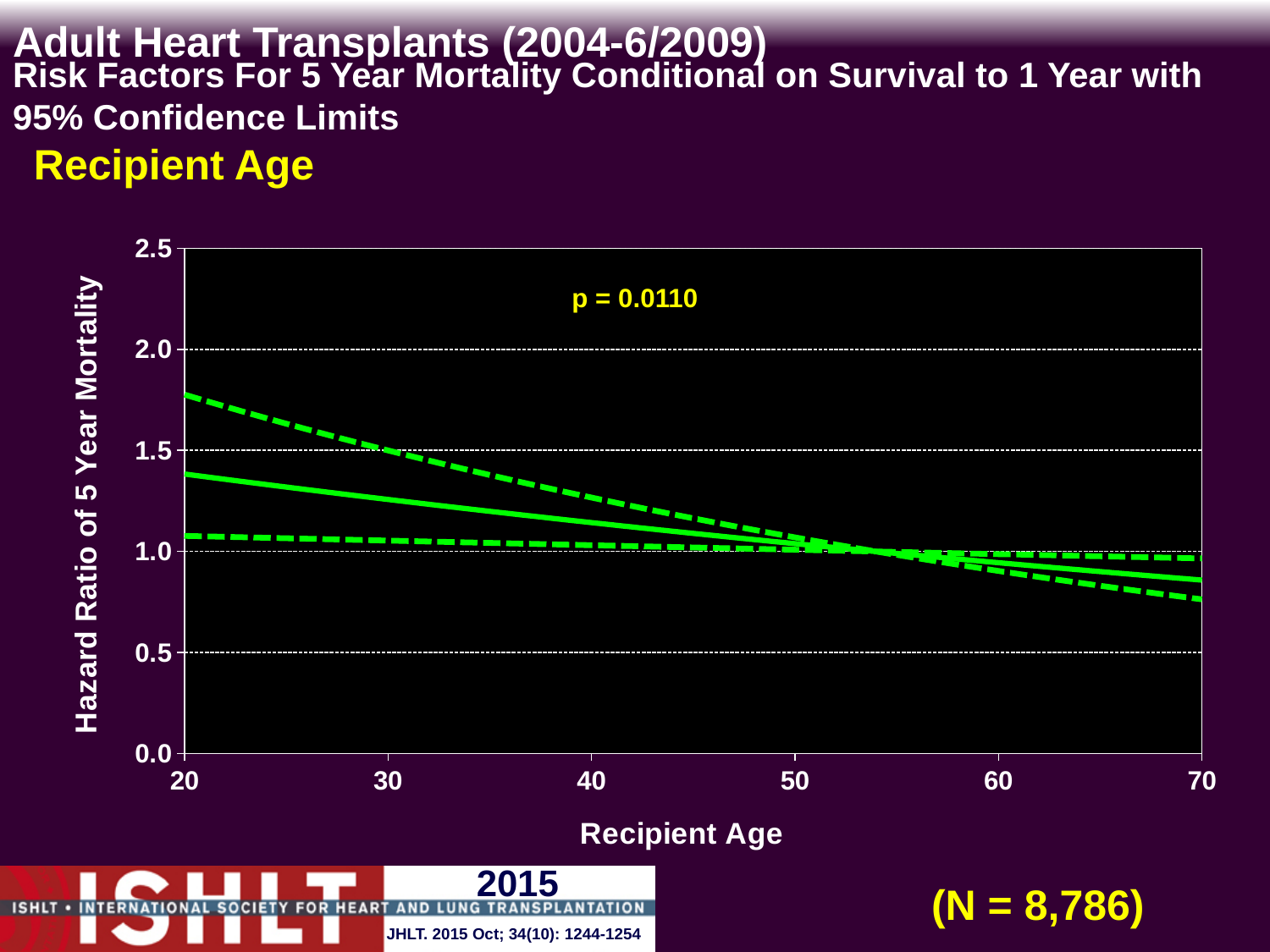
What p-value is printed on the chart? p = 0.0110 Is the hazard ratio (solid line) at recipient age 20 greater or less than 1.5? less Is the lower confidence limit (lower dashed line) at recipient age 70 greater or less than 1.0? less What is the label of the y-axis? Hazard Ratio of 5 Year Mortality What sample size (N) is shown on the slide? N = 8,786 What is the label of the x-axis? Recipient Age Is the upper confidence limit (upper dashed line) at recipient age 20 greater or less than 1.5? greater Does the solid hazard ratio line rise or fall as recipient age increases from 20 to 70? fall How many lines are plotted on the chart? 3 What kind of chart is shown on the slide? line chart